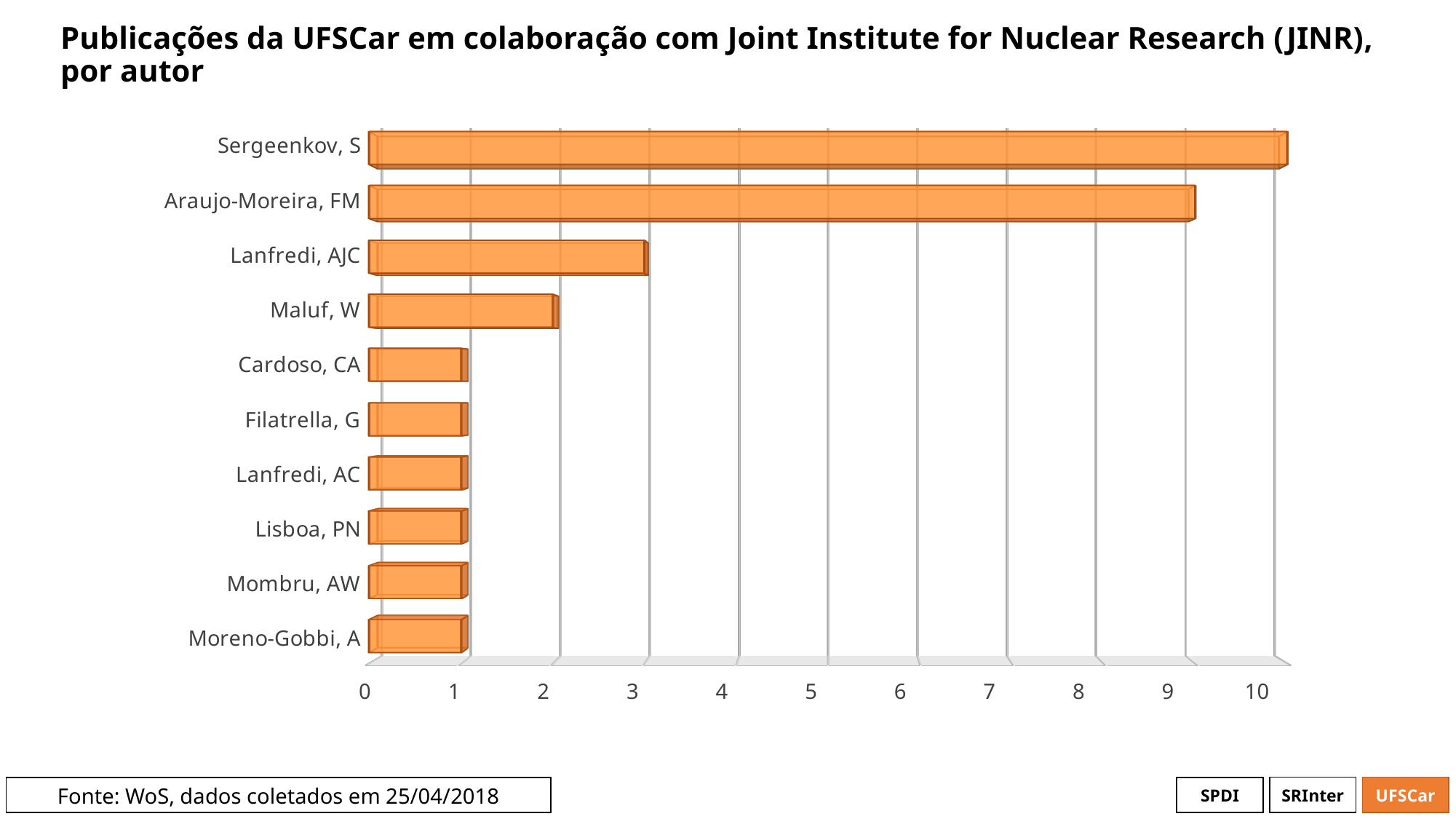
What is the source of the data cited on the slide? WoS, dados coletados em 25/04/2018 How many authors are listed in the chart? 10 Is the value for Maluf, W greater or less than 5? less How many publications does Maluf, W have? 2 What kind of chart is shown on the slide? bar chart How many publications does Araujo-Moreira, FM have? 9 Is the value for Araujo-Moreira, FM greater or less than 5? greater How many publications does Cardoso, CA have? 1 How many publications does Lanfredi, AJC have? 3 Which author has the highest number of publications? Sergeenkov, S How many publications does Sergeenkov, S have? 10 Who has more publications, Lanfredi, AJC or Maluf, W? Lanfredi, AJC